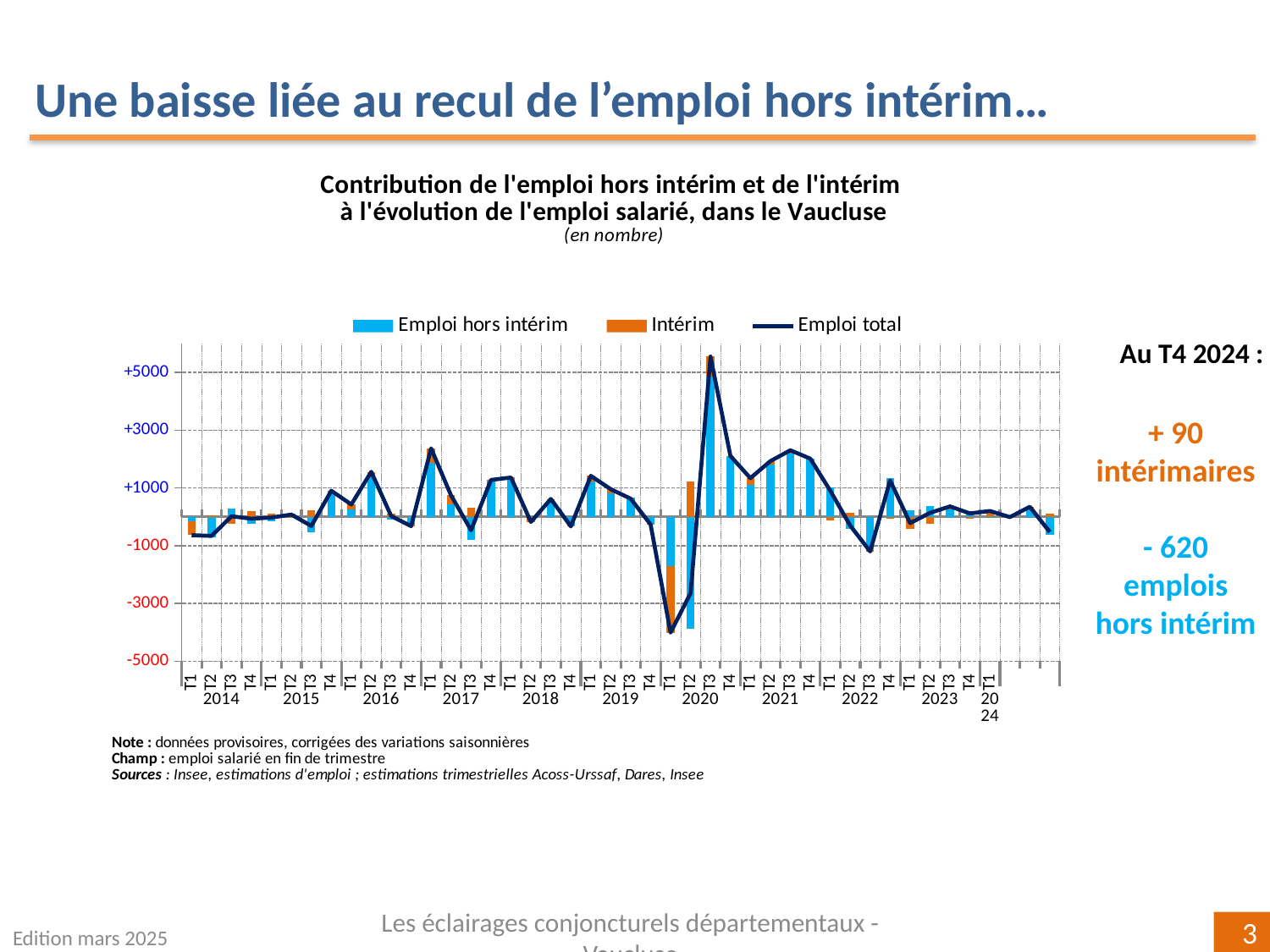
Is the value of Emploi total at T3 2020 greater or less than +5000? greater According to the slide, what is the contribution of emploi hors intérim at T4 2024? - 620 According to the slide, what is the contribution of intérim at T4 2024? + 90 In which quarter does the Emploi total line reach its lowest value? T1 2020 Is the value of Emploi total at T1 2017 greater or less than +1000? greater What kind of chart is shown on the slide? A combined bar and line chart What is the title of the chart? Contribution de l'emploi hors intérim et de l'intérim à l'évolution de l'emploi salarié, dans le Vaucluse Is the value of Emploi total at T1 2020 greater or less than -3000? less How many series does the legend list? 3 In which quarter does the Emploi total line reach its highest value? T3 2020 What are the three series named in the legend? Emploi hors intérim, Intérim, Emploi total Which is larger, the Emploi total value at T3 2020 or at T1 2017? T3 2020